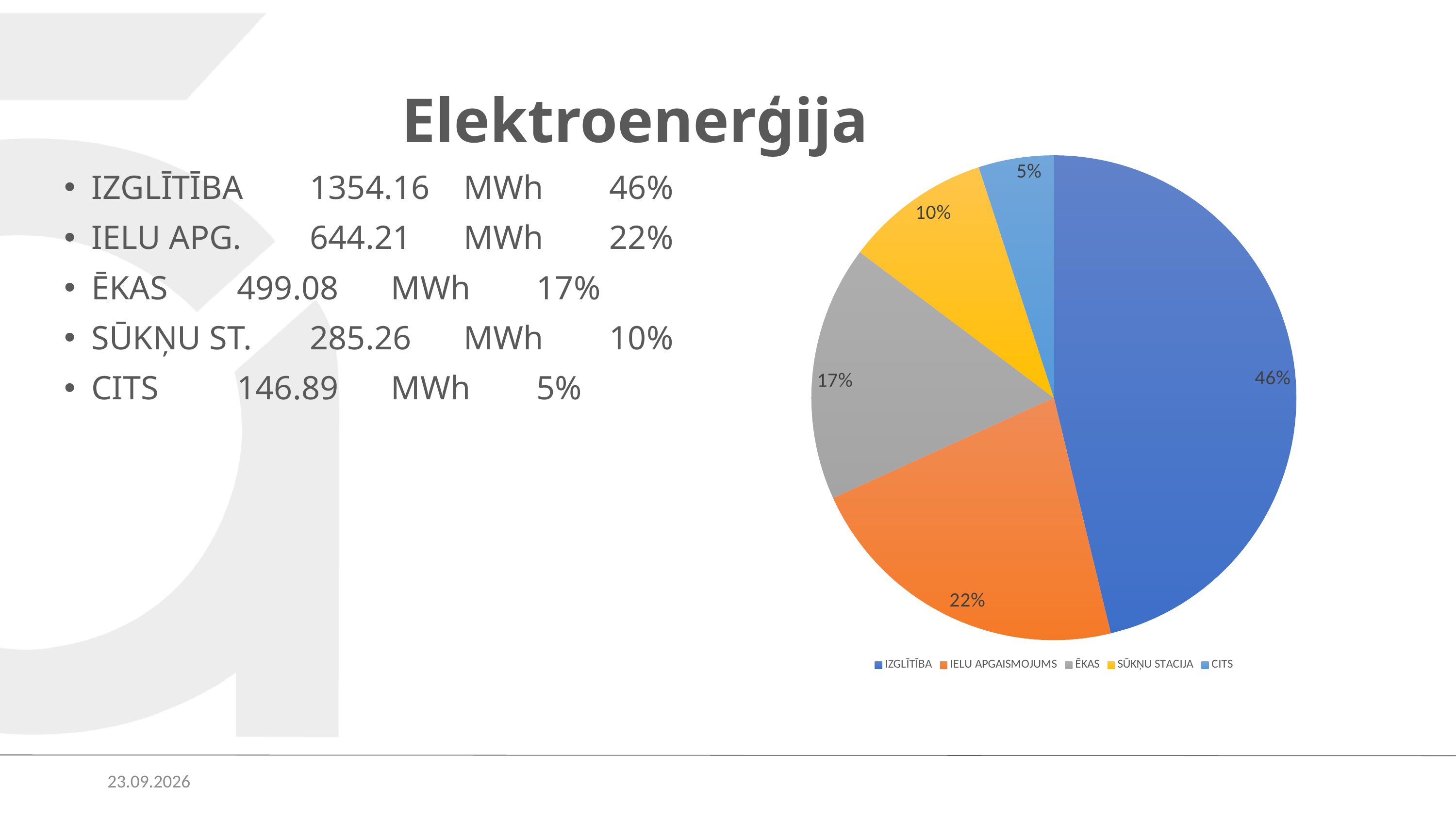
What share of the pie does IELU APGAISMOJUMS have? 22% What kind of chart is shown on the slide? pie chart How many categories does the pie chart show? 5 What share of the pie does IZGLĪTĪBA have? 46% Which slice is larger, ĒKAS or SŪKŅU STACIJA? ĒKAS What colour is the IELU APGAISMOJUMS slice in the pie chart? orange What is the difference in percentage points between the IZGLĪTĪBA slice and the IELU APGAISMOJUMS slice? 24 What share of the pie does SŪKŅU STACIJA have? 10% Which category has the smallest slice of the pie? CITS Which category has the largest slice of the pie? IZGLĪTĪBA